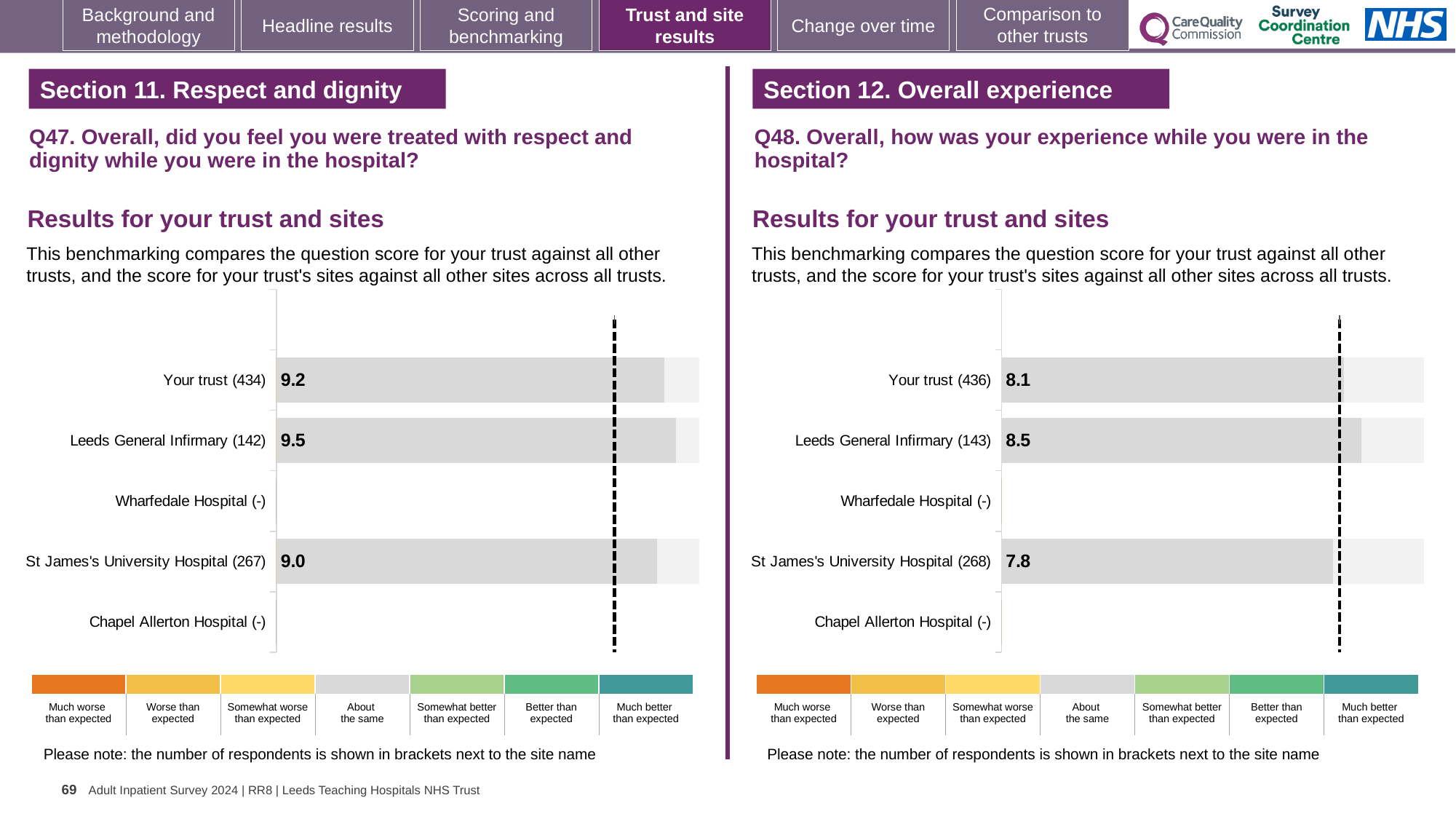
How many site or trust rows are listed on the Q48 chart (right)? 5 What type of chart is used on the Q47 chart (left)? Bar chart On the Q48 chart (right), what is the difference between the scores for Leeds General Infirmary and St James's University Hospital? 0.7 On the Q47 chart (left), what is the score for Leeds General Infirmary? 9.5 On the Q48 chart (right), which has the higher score, Your trust or Leeds General Infirmary? Leeds General Infirmary On the Q48 chart (right), what is the score for Your trust? 8.1 On the Q47 chart (left), which site or trust has the highest score? Leeds General Infirmary On the Q48 chart (right), which site or trust has the lowest score shown? St James's University Hospital On the Q48 chart (right), what is the score for St James's University Hospital? 7.8 On the Q47 chart (left), what is the score for Your trust? 9.2 On the Q47 chart (left), what is the difference between the scores for Leeds General Infirmary and Your trust? 0.3 On the Q47 chart (left), how many respondents are shown for St James's University Hospital? 267